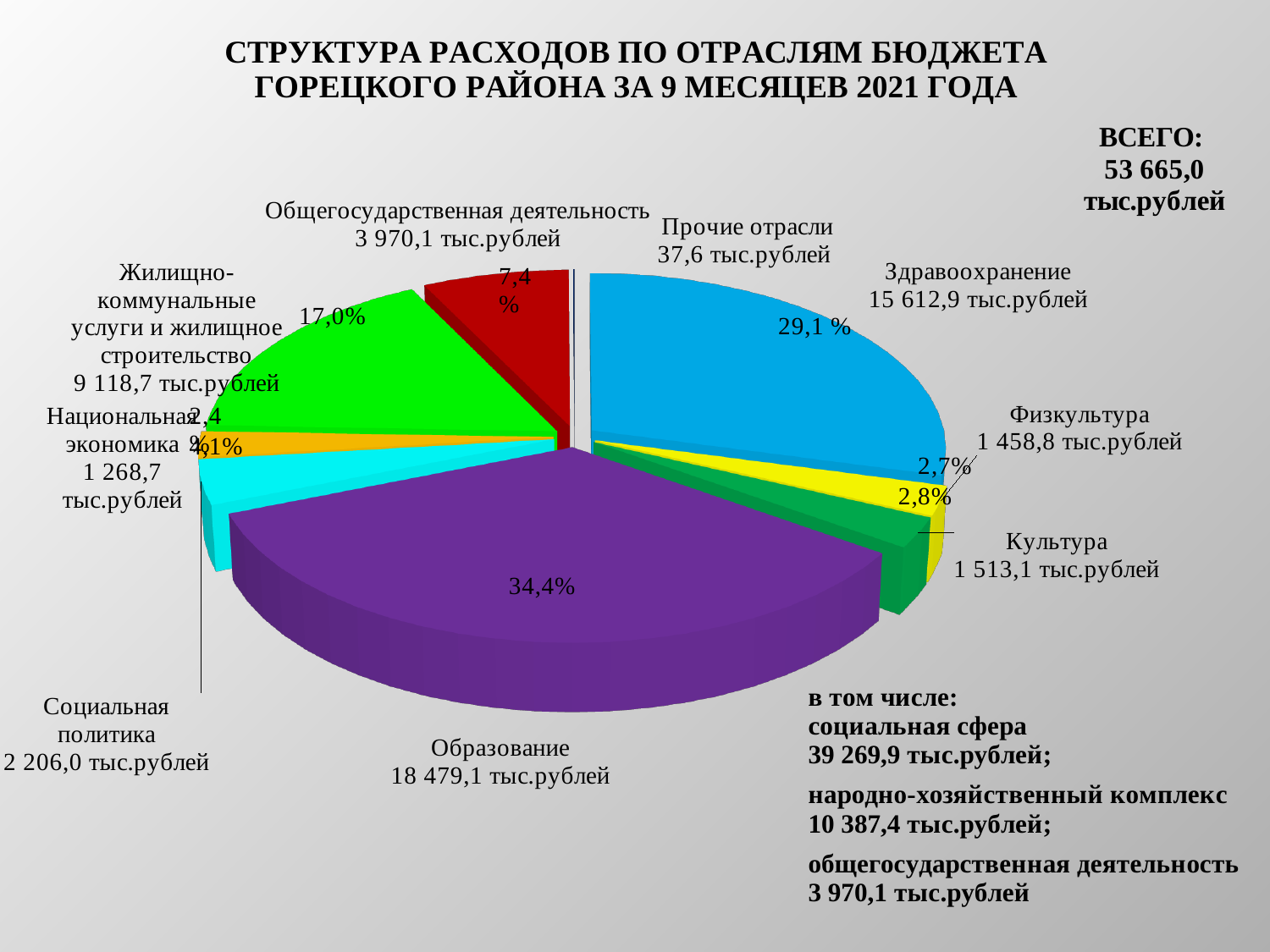
What is the value for Жилищно-коммунальные услуги и жилищное строительство? 9 118,7 тыс.рублей Which is larger, Культура or Физкультура? Культура What is the value for Прочие отрасли? 37,6 тыс.рублей Which category has the largest slice of the pie? Образование What percentage share of the pie does Здравоохранение have? 29,1 % What is the difference between Образование and Здравоохранение in тыс.рублей? 2 866,2 тыс.рублей What kind of chart is shown on the slide? Pie chart Which category has the smallest slice of the pie? Прочие отрасли What is the value for Здравоохранение? 15 612,9 тыс.рублей What is the value for Образование? 18 479,1 тыс.рублей What percentage share of the pie does Образование have? 34,4% How many categories are shown in the pie chart? 9